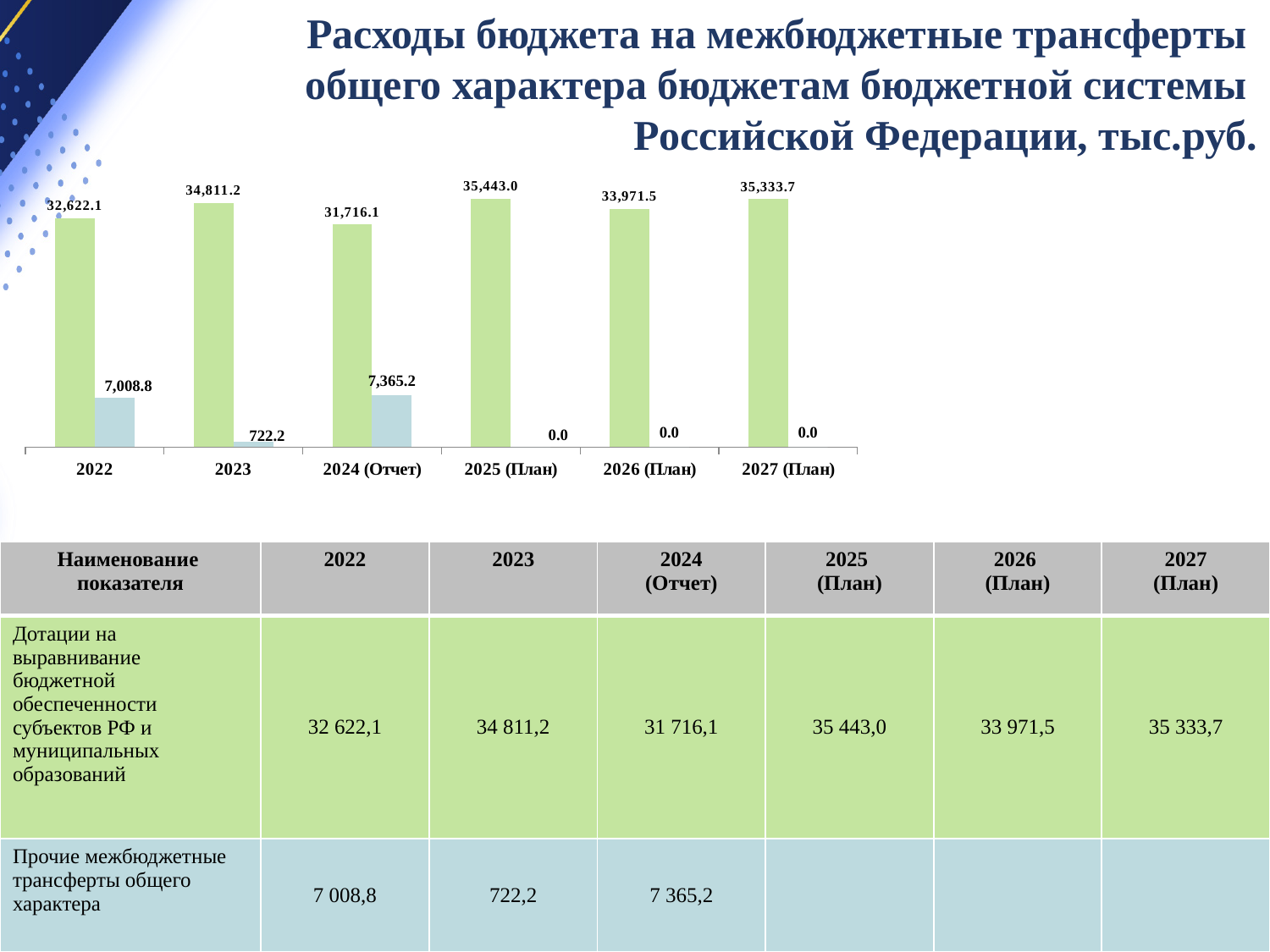
What is the value of the light blue bar for 2023? 722.2 What type of chart is shown on the slide? bar chart What is the difference between the green bar values for 2023 and 2022? 2,189.1 In which year is the green bar (Дотации на выравнивание) the lowest? 2024 (Отчет) How many year categories are shown on the x axis of the chart? 6 How many years show a value of 0.0 for the light blue series (Прочие межбюджетные трансферты)? 3 Which year has the larger green bar value, 2026 (План) or 2027 (План)? 2027 (План) What is the value of the green bar (Дотации на выравнивание бюджетной обеспеченности) for 2022? 32,622.1 In which year does the green bar (Дотации на выравнивание) reach its highest value? 2025 (План) Does the green bar value rise or fall from 2022 to 2023? rise What is the difference between the light blue bar values for 2024 (Отчет) and 2023? 6,643.0 What is the value of the light blue bar (Прочие межбюджетные трансферты общего характера) for 2024 (Отчет)? 7,365.2